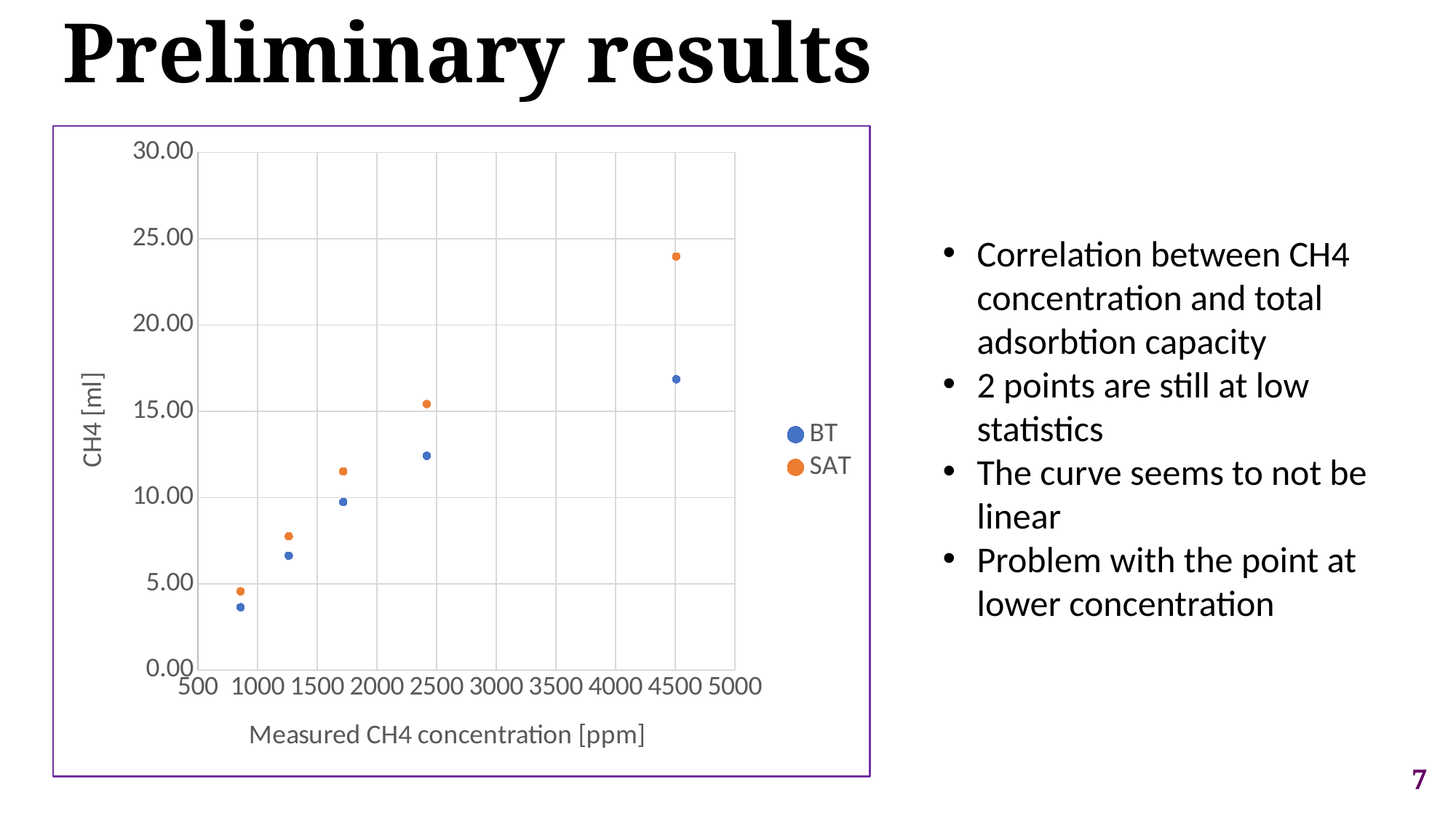
At the highest measured concentration (around 4500 ppm), which series has the larger CH4 [ml] value, BT or SAT? SAT What are the two series named in the chart legend? BT and SAT Is the SAT value at the highest concentration (around 4500 ppm) greater or less than 20.00? greater What is the title of the x axis of the chart? Measured CH4 concentration [ppm] Is the BT value at the highest concentration (around 4500 ppm) greater or less than 20.00? less How many series does the chart legend list? 2 How many data points are plotted for the BT series? 5 Do the CH4 [ml] values rise or fall as the measured CH4 concentration increases? rise Which series contains the highest plotted CH4 [ml] value on the chart? SAT What kind of chart is shown on the slide? scatter chart Is the BT value at the lowest concentration (below 1000 ppm) greater or less than 5.00? less How many data points are plotted for the SAT series? 5